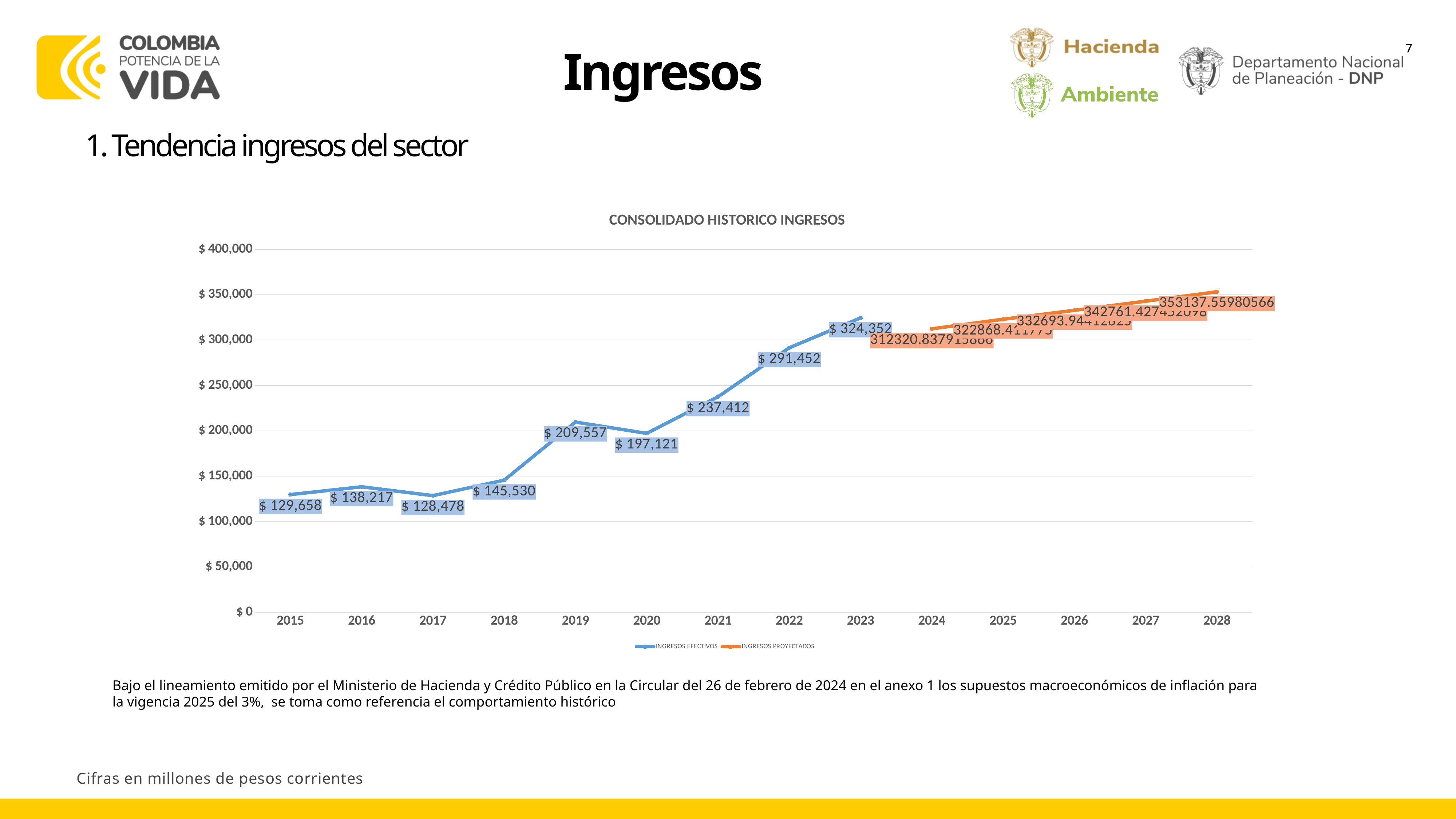
Which year has the lowest value of INGRESOS EFECTIVOS? 2017 How many series does the legend list? 2 What is the difference between the INGRESOS EFECTIVOS values for 2022 and 2021? $ 54,040 Which is larger, the INGRESOS EFECTIVOS value for 2019 or for 2020? 2019 Is the INGRESOS PROYECTADOS value for 2025 greater or less than $ 300,000? greater What is the value of INGRESOS PROYECTADOS for 2028? 353137.55980566 How many years are shown on the x axis? 14 What is the value of INGRESOS EFECTIVOS for 2019? $ 209,557 What is the value of INGRESOS EFECTIVOS for 2015? $ 129,658 Which year has the highest value of INGRESOS EFECTIVOS? 2023 What type of chart is shown under the title CONSOLIDADO HISTORICO INGRESOS? line chart What is the value of INGRESOS EFECTIVOS for 2023? $ 324,352